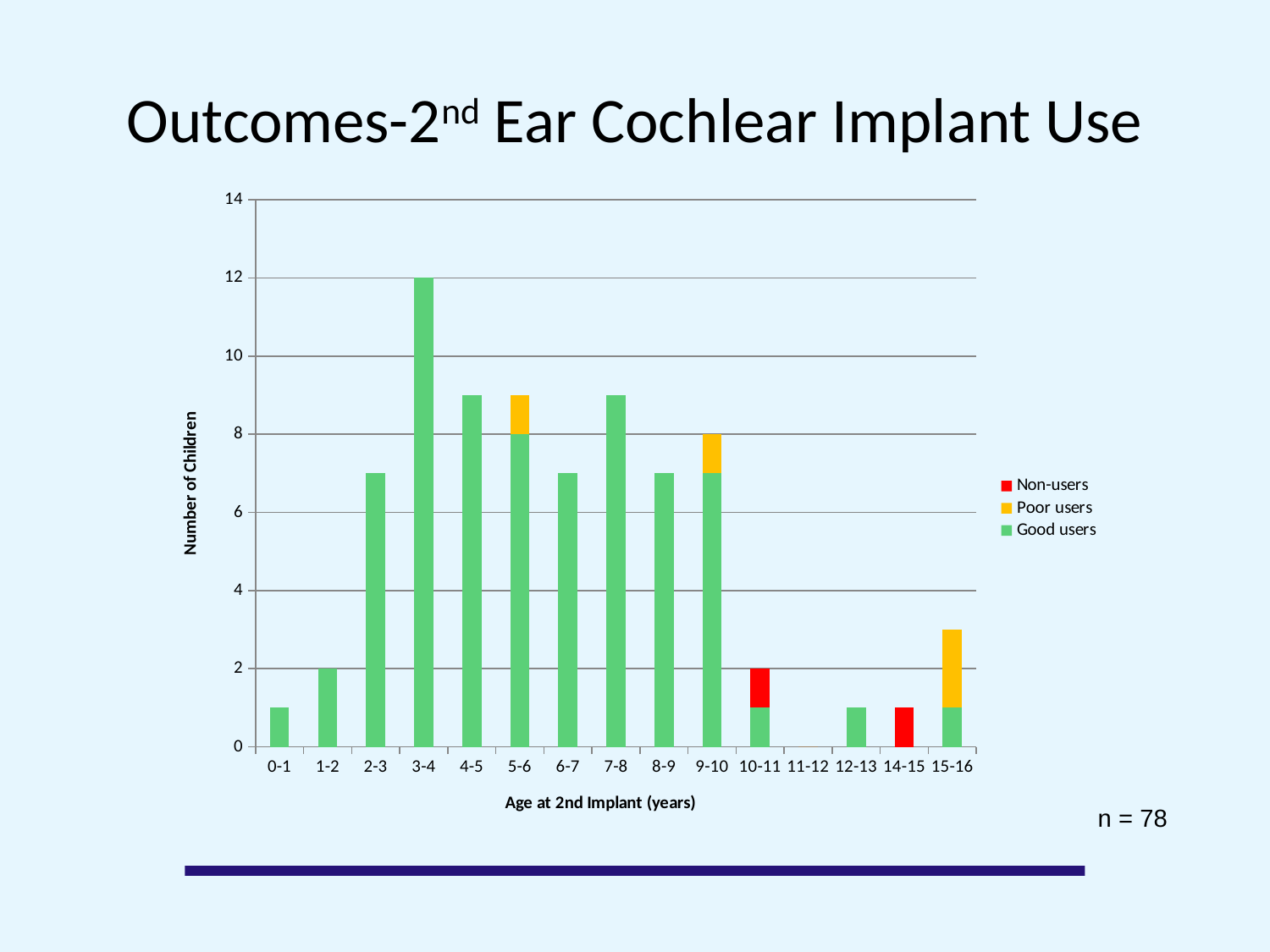
Which is larger, the bar for 3-4 or the bar for 4-5? 3-4 Which age group has no children plotted at all? 11-12 How many series does the legend list? 3 How many age-group categories are shown on the x axis? 15 Which age group has the highest number of children? 3-4 How many children are in the 1-2 age group? 2 Is the value for the 4-5 age group greater or less than 8? greater How many children are in the 3-4 age group? 12 What is the total height of the stacked bar for the 9-10 age group? 8 Is the value for the 2-3 age group greater or less than 6? greater What is the total height of the stacked bar for the 10-11 age group? 2 What kind of chart is shown on the slide? bar chart